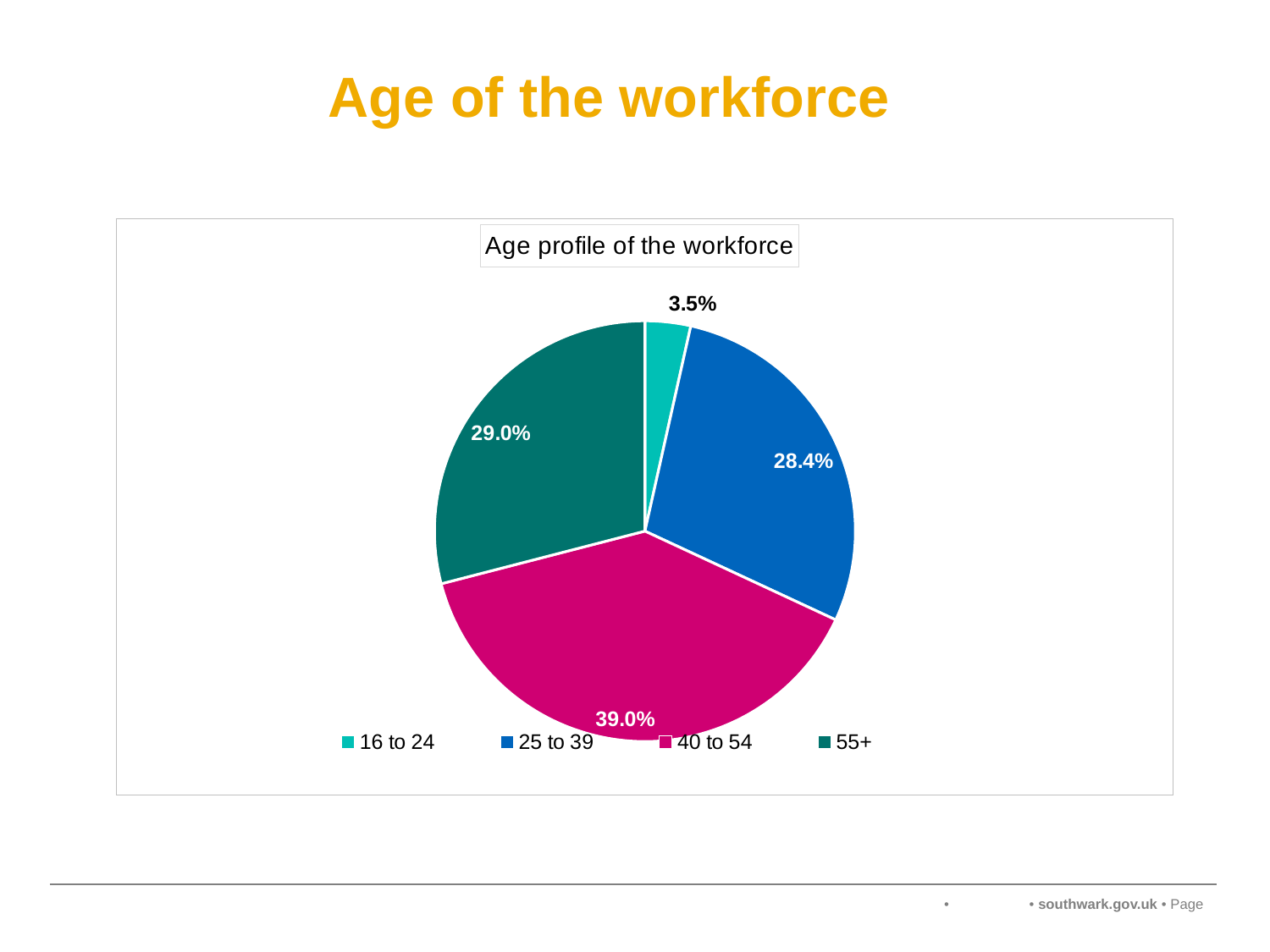
What colour is the slice for the 40 to 54 age group? Magenta What is the difference in percentage points between the 40 to 54 and 25 to 39 age groups? 10.6 What is the chart's title? Age profile of the workforce Which age group has the largest share of the workforce? 40 to 54 What share of the workforce is aged 25 to 39? 28.4% How many age groups are shown in the pie chart? 4 Which age group has the smallest share of the workforce? 16 to 24 What share of the workforce is aged 55+? 29.0% Which is larger, the share for 55+ or the share for 25 to 39? 55+ What share of the workforce is aged 40 to 54? 39.0% What type of chart is shown on the slide? Pie chart What share of the workforce is aged 16 to 24? 3.5%